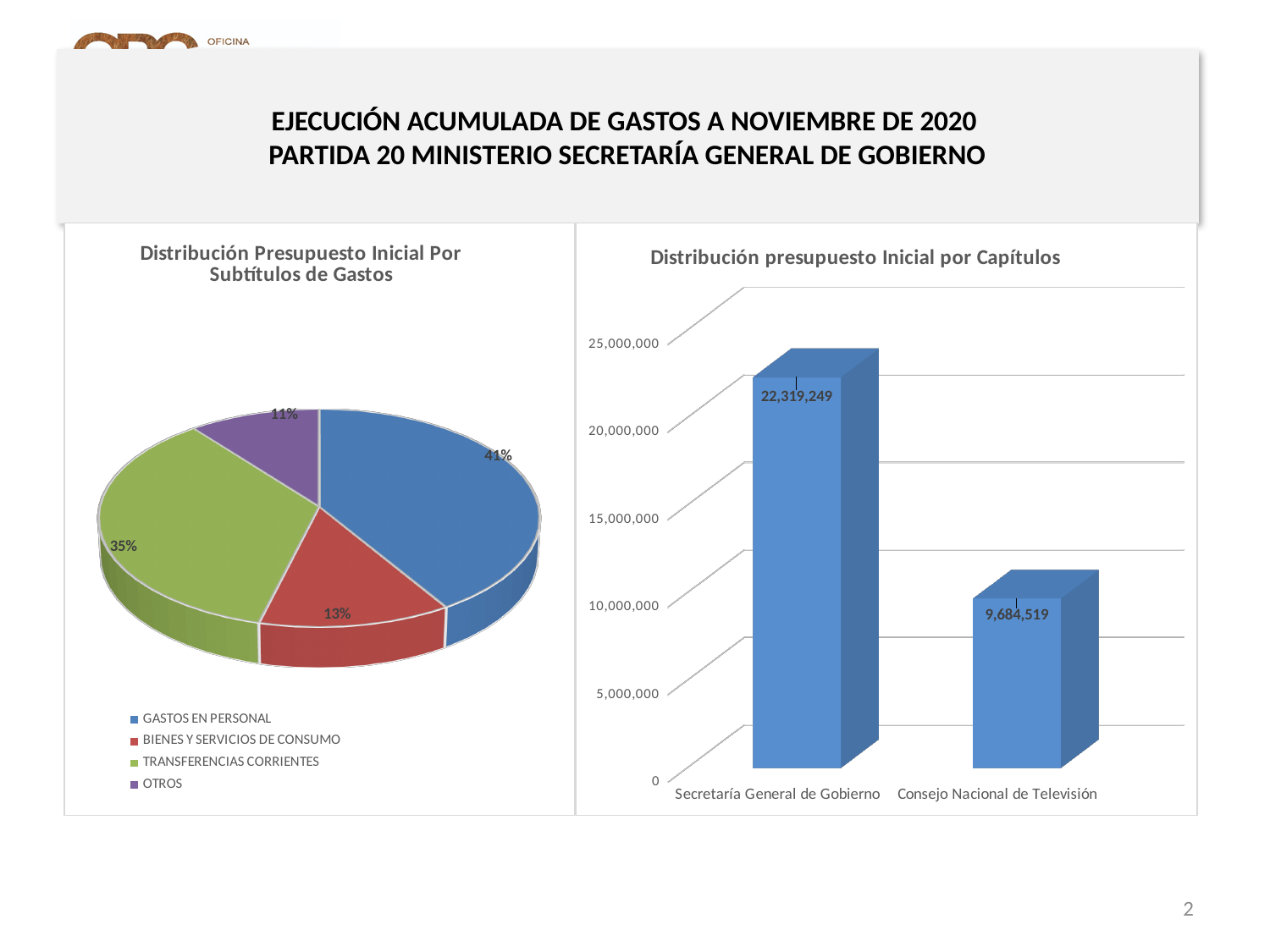
In the pie chart 'Distribución Presupuesto Inicial Por Subtítulos de Gastos', what is the difference in percentage points between GASTOS EN PERSONAL and BIENES Y SERVICIOS DE CONSUMO? 28 percentage points In the bar chart 'Distribución presupuesto Inicial por Capítulos', what is the value for Consejo Nacional de Televisión? 9,684,519 What kind of chart is 'Distribución presupuesto Inicial por Capítulos'? Bar chart In the pie chart 'Distribución Presupuesto Inicial Por Subtítulos de Gastos', which category has the smallest share? OTROS In the pie chart 'Distribución Presupuesto Inicial Por Subtítulos de Gastos', what share does OTROS have? 11% In the pie chart 'Distribución Presupuesto Inicial Por Subtítulos de Gastos', which category has the largest share? GASTOS EN PERSONAL In the bar chart 'Distribución presupuesto Inicial por Capítulos', what is the value for Secretaría General de Gobierno? 22,319,249 In the pie chart on the left, what colour is the TRANSFERENCIAS CORRIENTES slice? Green In the pie chart 'Distribución Presupuesto Inicial Por Subtítulos de Gastos', how many categories does the legend list? 4 In the pie chart 'Distribución Presupuesto Inicial Por Subtítulos de Gastos', what share does GASTOS EN PERSONAL have? 41% In the bar chart 'Distribución presupuesto Inicial por Capítulos', what is the difference between Secretaría General de Gobierno and Consejo Nacional de Televisión? 12,634,730 In the pie chart 'Distribución Presupuesto Inicial Por Subtítulos de Gastos', what share does TRANSFERENCIAS CORRIENTES have? 35%